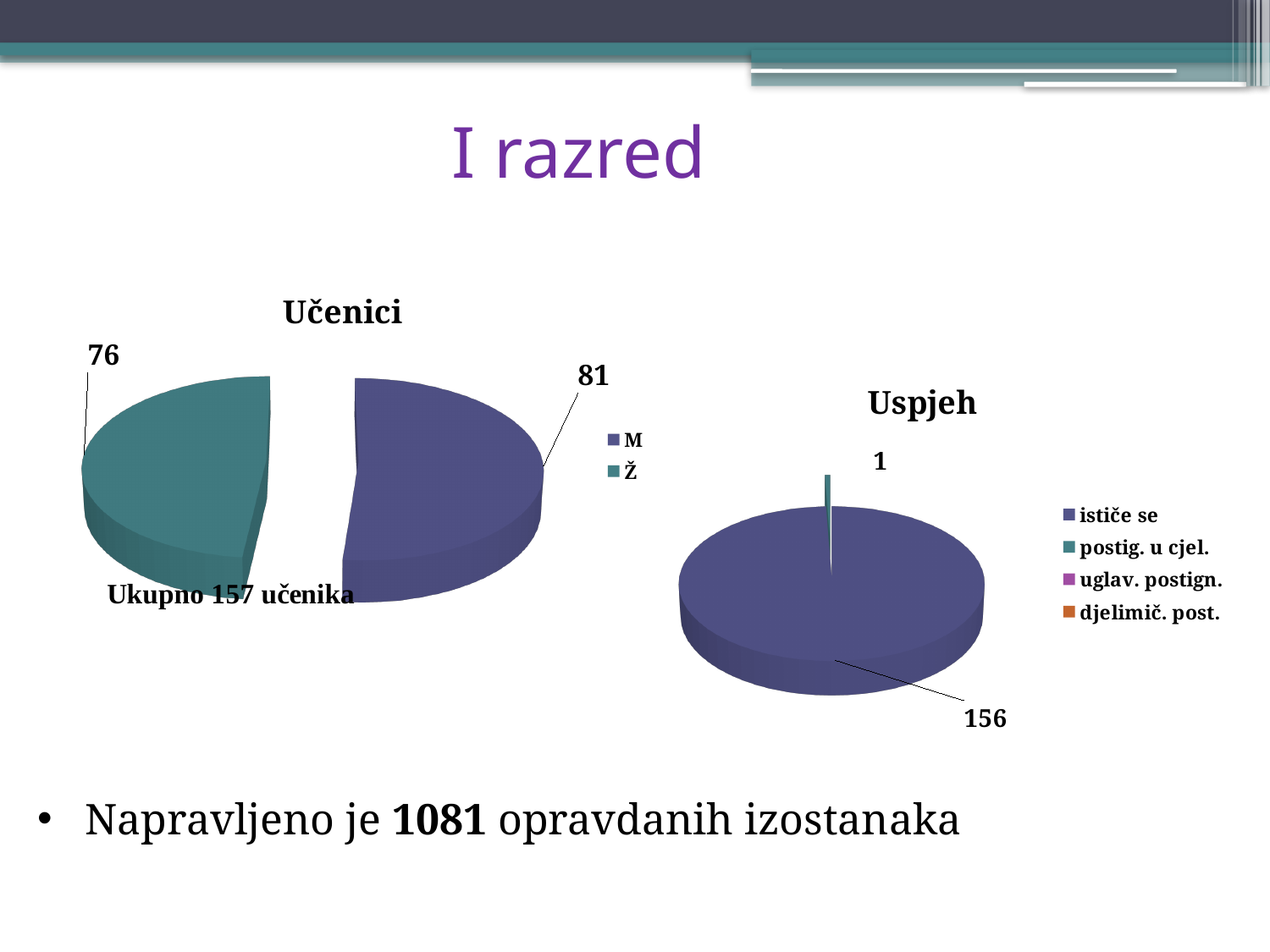
How many entries does the legend of the 'Uspjeh' chart list? 4 In the 'Uspjeh' chart, what is the value for 'ističe se'? 156 In the 'Učenici' chart, what is the value for M? 81 In the 'Uspjeh' chart, what is the value for 'postig. u cjel.'? 1 In the 'Uspjeh' chart, what is the difference between the values for 'ističe se' and 'postig. u cjel.'? 155 In the 'Uspjeh' chart, which category has the highest value? ističe se What is the title of the chart on the left of the slide? Učenici In the 'Učenici' chart, what is the difference between the values for M and Ž? 5 In the 'Učenici' chart, what is the total of the two slices? 157 In the 'Učenici' chart, what is the value for Ž? 76 In the 'Učenici' chart, which category has the larger value, M or Ž? M What kind of chart is the 'Učenici' chart? Pie chart